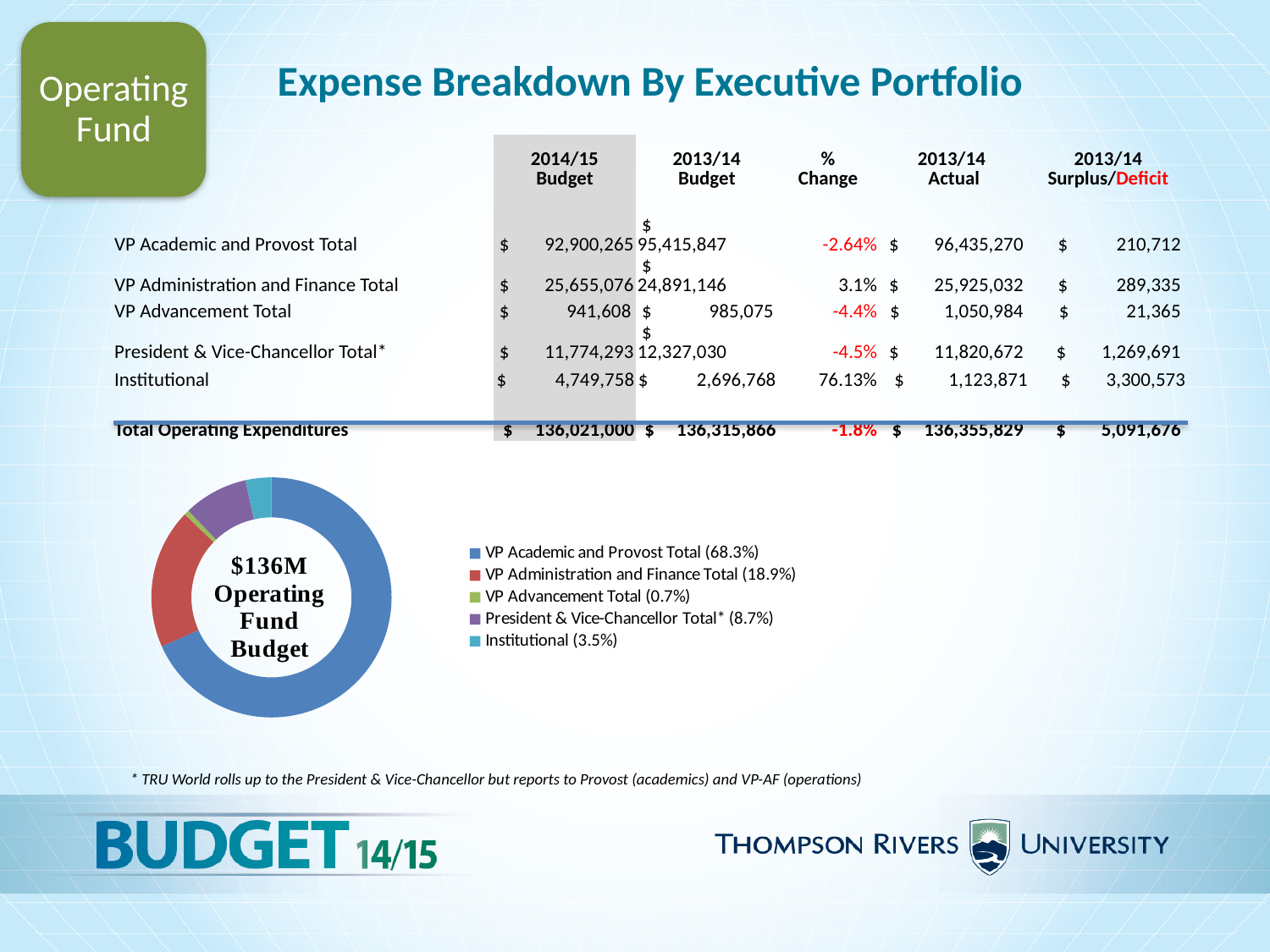
What share of the Operating Fund Budget does Institutional represent in the doughnut chart? 3.5% Which category has the smallest share in the doughnut chart? VP Advancement Total What share of the Operating Fund Budget does President & Vice-Chancellor Total* represent in the doughnut chart? 8.7% What kind of chart is shown on the slide? Doughnut chart Which category has the largest share in the doughnut chart? VP Academic and Provost Total In the doughnut chart, which has a larger share: President & Vice-Chancellor Total* or Institutional? President & Vice-Chancellor Total* What is the difference in percentage points between the shares of VP Academic and Provost Total and VP Administration and Finance Total in the doughnut chart? 49.4 percentage points What share of the Operating Fund Budget does VP Academic and Provost Total represent in the doughnut chart? 68.3% What text is shown in the centre of the doughnut chart? $136M Operating Fund Budget How many categories does the doughnut chart's legend list? 5